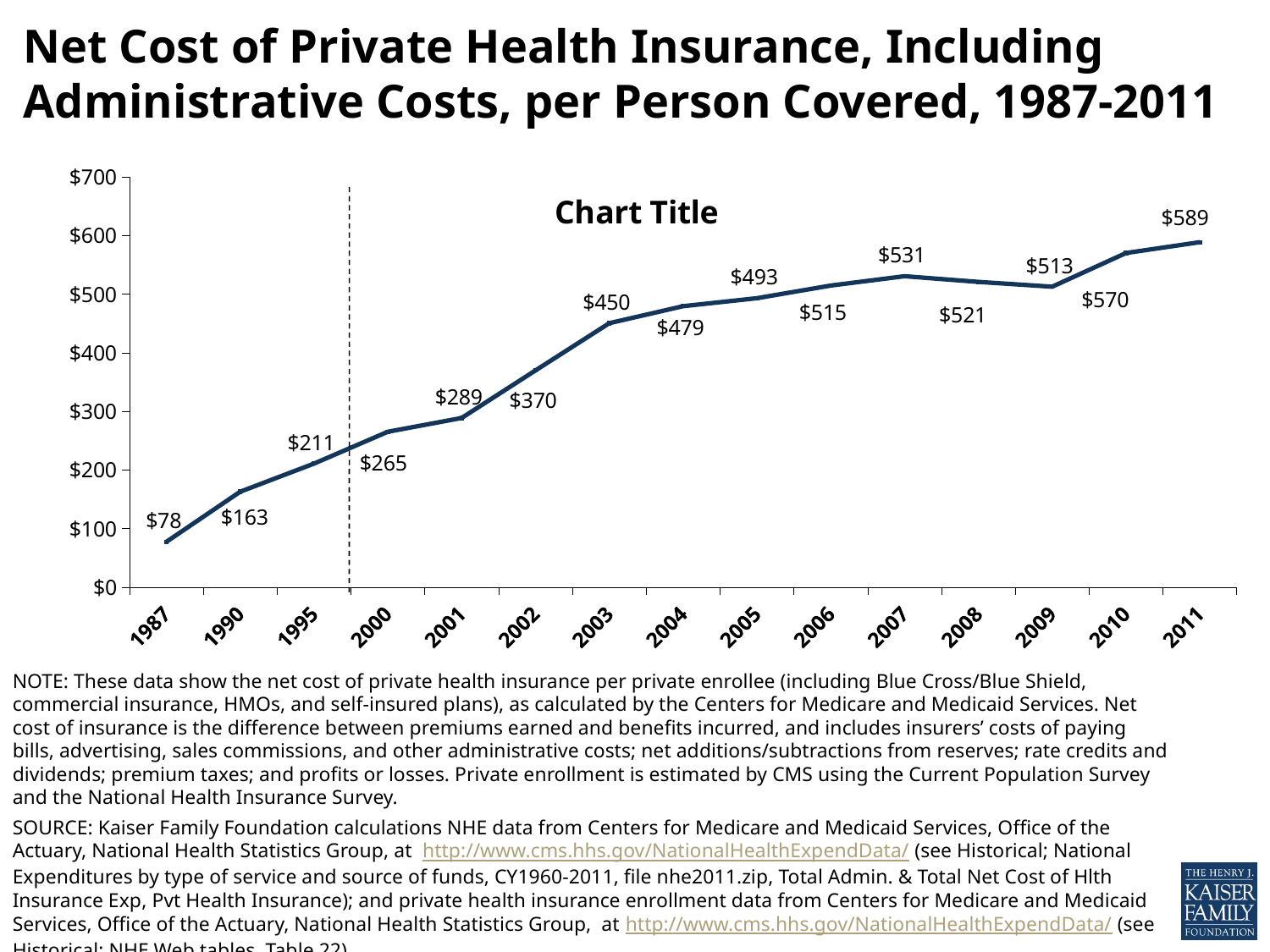
What kind of chart is shown on the slide? Line chart How many years are plotted on the x axis? 15 Which year has the lowest value on the chart? 1987 What is the value shown for 2003? $450 What is the value shown for 2007? $531 What is the difference between the values for 2010 and 2009? $57 What is the net cost of private health insurance per person covered in 1987? $78 Which year has the highest value on the chart? 2011 Which is larger, the value for 2007 or the value for 2008? 2007 What is the value shown for 2011? $589 What is the difference between the values for 2011 and 1987? $511 Do the values generally rise or fall from 1987 to 2011? Rise